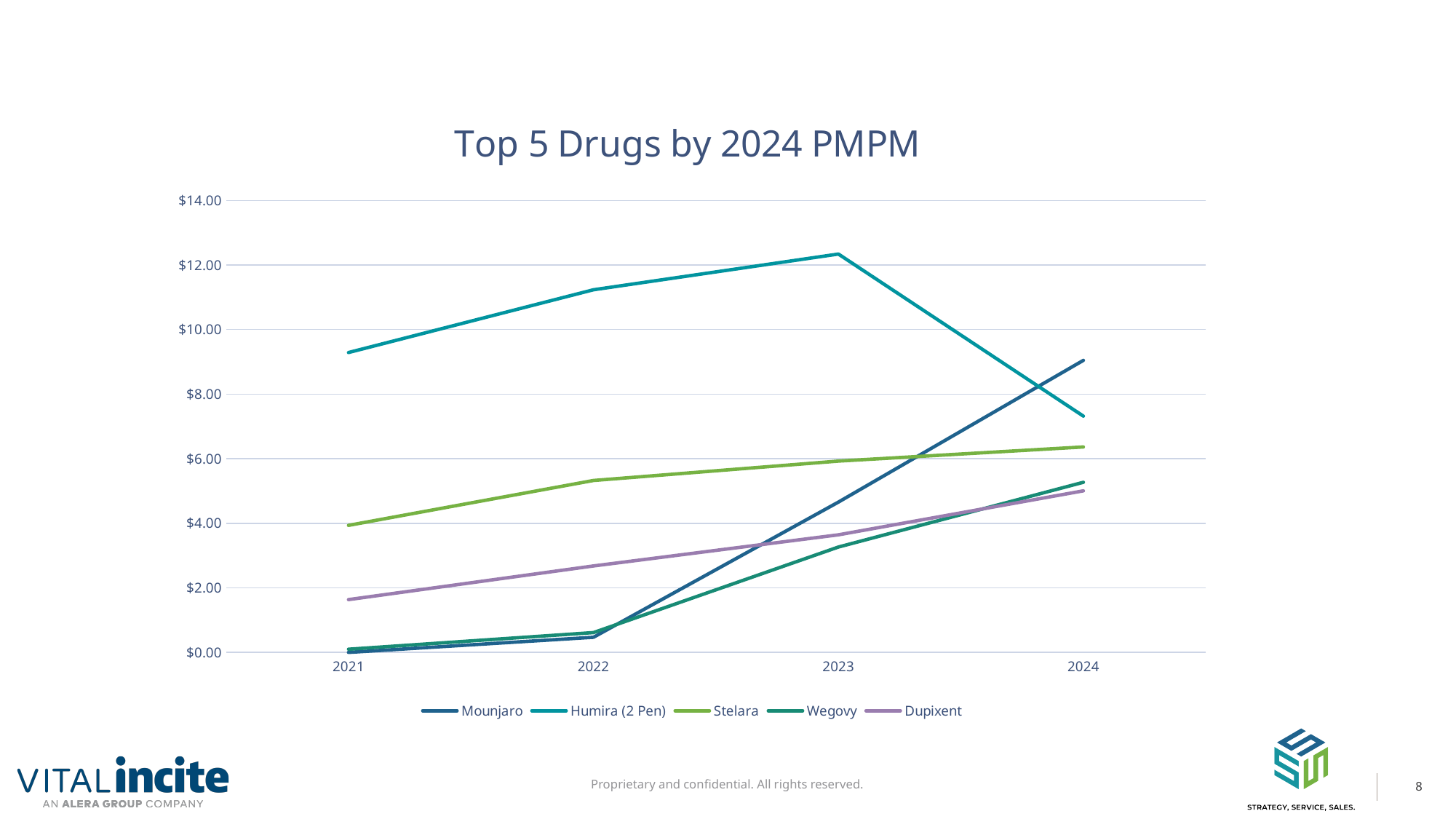
In 2024, which is larger: the value for Humira (2 Pen) or the value for Stelara? Humira (2 Pen) Which drug has the highest PMPM in 2024? Mounjaro Is the value for Humira (2 Pen) in 2023 greater or less than $10.00? greater What kind of chart is shown on the slide? line chart Which drug has the highest PMPM in 2023? Humira (2 Pen) How many series does the legend list? 5 Is the value for Stelara in 2021 greater or less than $6.00? less How many years are shown on the x axis? 4 Is the value for Mounjaro in 2024 greater or less than $8.00? greater In 2021, which is larger: the value for Dupixent or the value for Stelara? Stelara Does the Mounjaro line rise or fall from 2021 to 2024? rise Does the Humira (2 Pen) line rise or fall from 2023 to 2024? fall